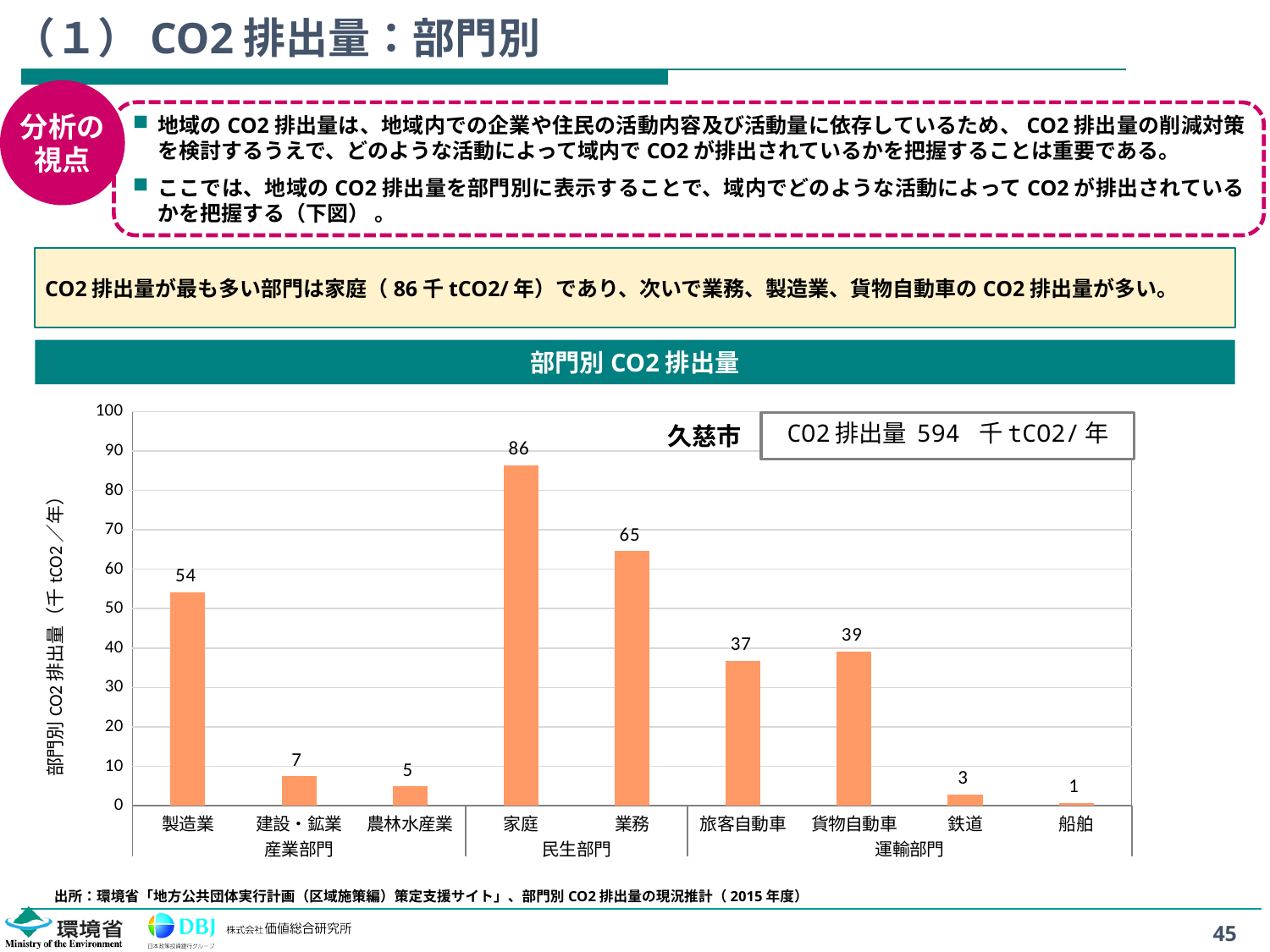
What is the value shown for 貨物自動車? 39 What is the value shown for 製造業? 54 What kind of chart is shown on the slide? bar chart Is the value for 業務 greater or less than 60? greater Which category has the highest CO2 emissions in the chart? 家庭 What is the title of the chart on the slide? 部門別CO2排出量 Which is larger, the value for 旅客自動車 or 貨物自動車? 貨物自動車 What is the difference between the values for 家庭 and 業務? 21 Which category has the lowest CO2 emissions in the chart? 船舶 What is the CO2 emission value for 家庭 in the 部門別CO2排出量 chart? 86 What is the difference between the values for 建設・鉱業 and 農林水産業? 2 How many categories are plotted in the chart? 9